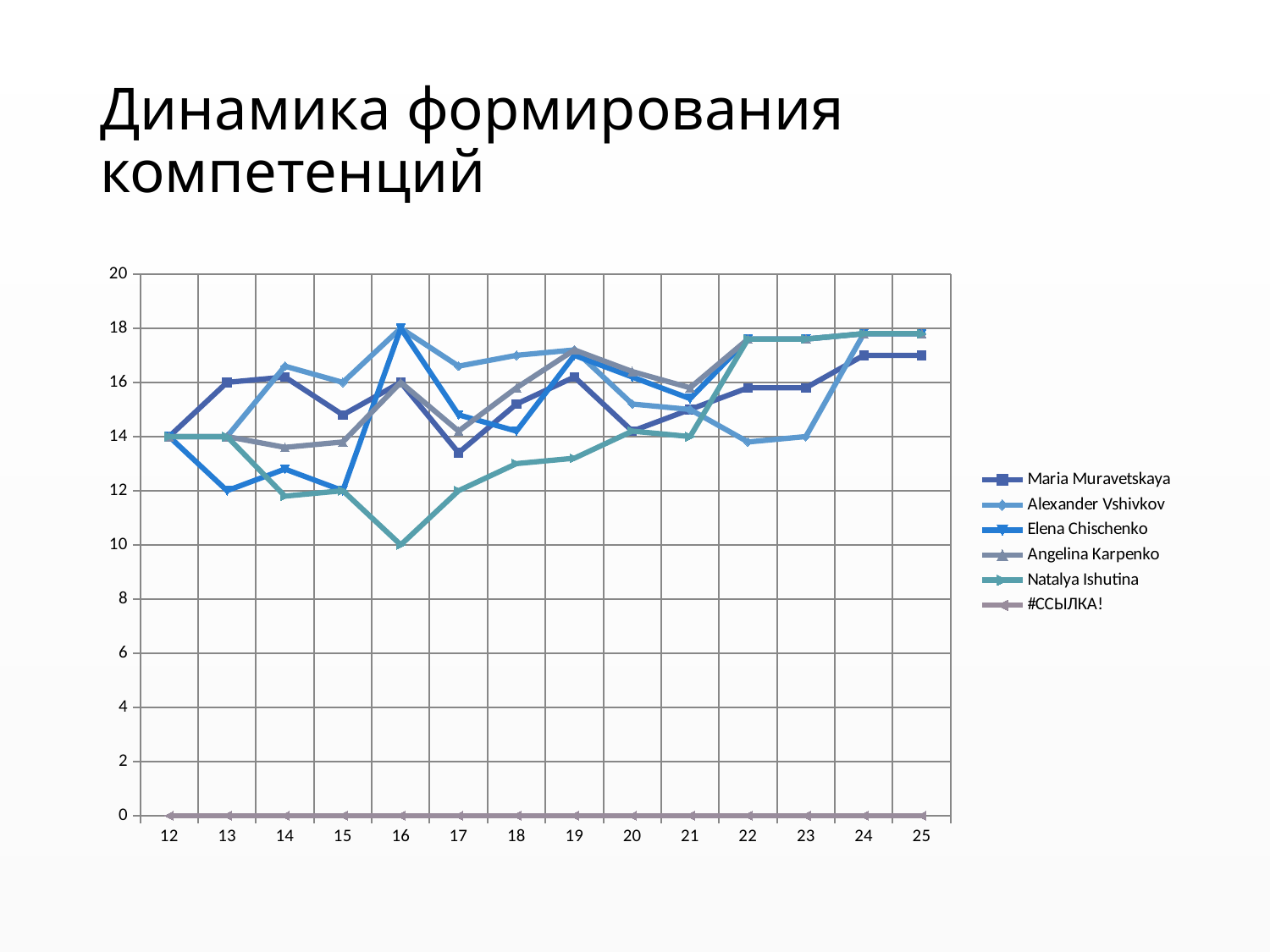
What is the value for Elena Chischenko at 16? 18 How many series does the legend list? 6 How many points are on the x axis of the chart? 14 What is the value for Elena Chischenko at 13? 12 Is the value for Maria Muravetskaya at 17 greater or less than 14? less Among the five named participants, which series has the lowest value at 16? Natalya Ishutina What is the value for Natalya Ishutina at 16? 10 Is the value for Alexander Vshivkov at 14 greater or less than 16? greater What kind of chart is shown on the slide? line chart Does the Natalya Ishutina series rise or fall from 16 to 25? rise Which series has the highest value at 16? Alexander Vshivkov and Elena Chischenko (tied at 18) What is the value for Maria Muravetskaya at 12? 14